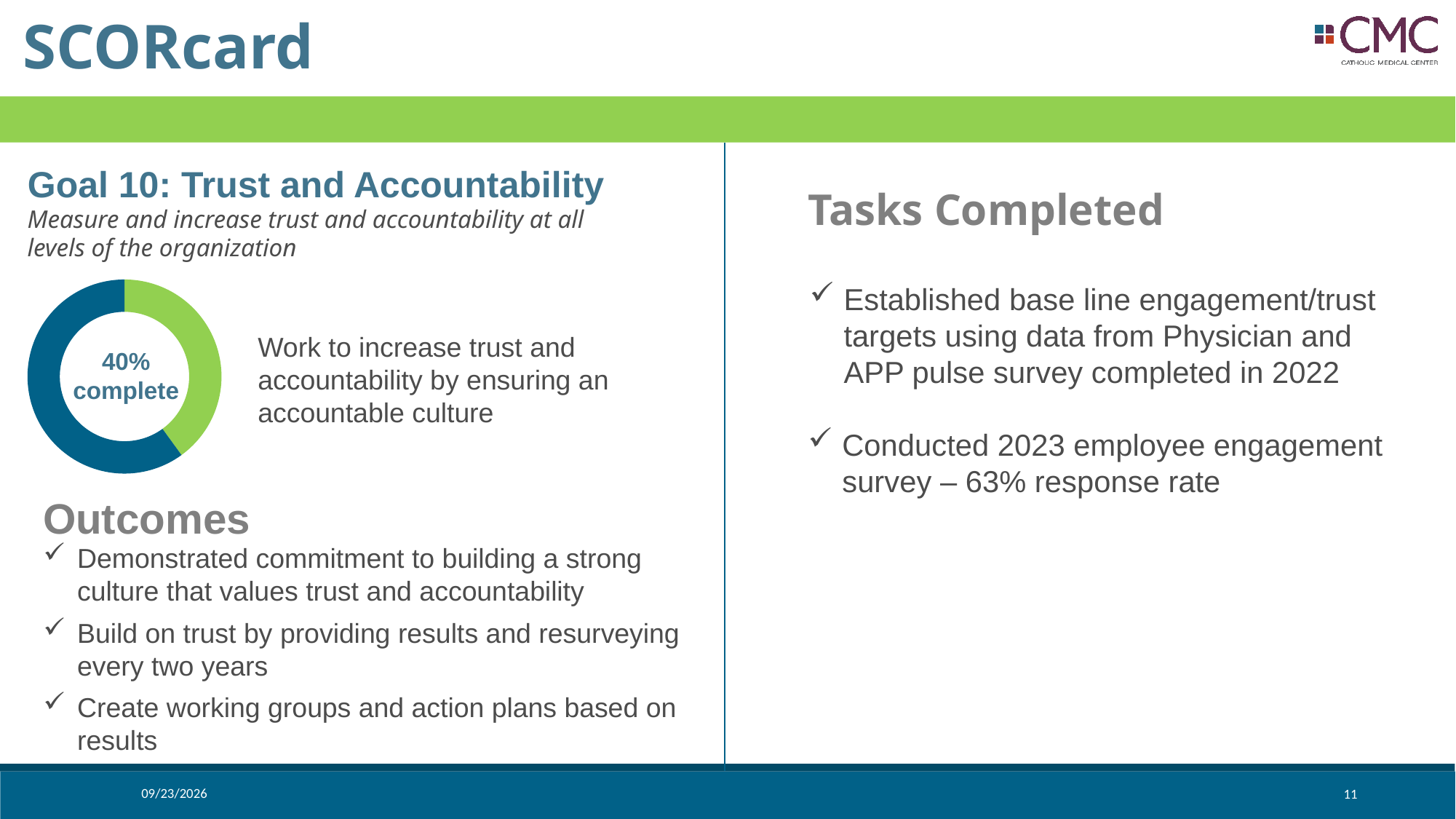
What percentage complete does the donut chart show? 40% complete What kind of chart is shown on the slide? Donut chart Is the completed portion shown in the donut chart greater or less than 50%? less How many slices does the donut chart have? 2 What text is printed in the centre of the donut chart? 40% complete Which slice of the donut chart is larger, the green one or the dark blue one? The dark blue one What colour is the slice representing the completed portion in the donut chart? Green What share of the donut chart does the green (completed) slice represent? 40%